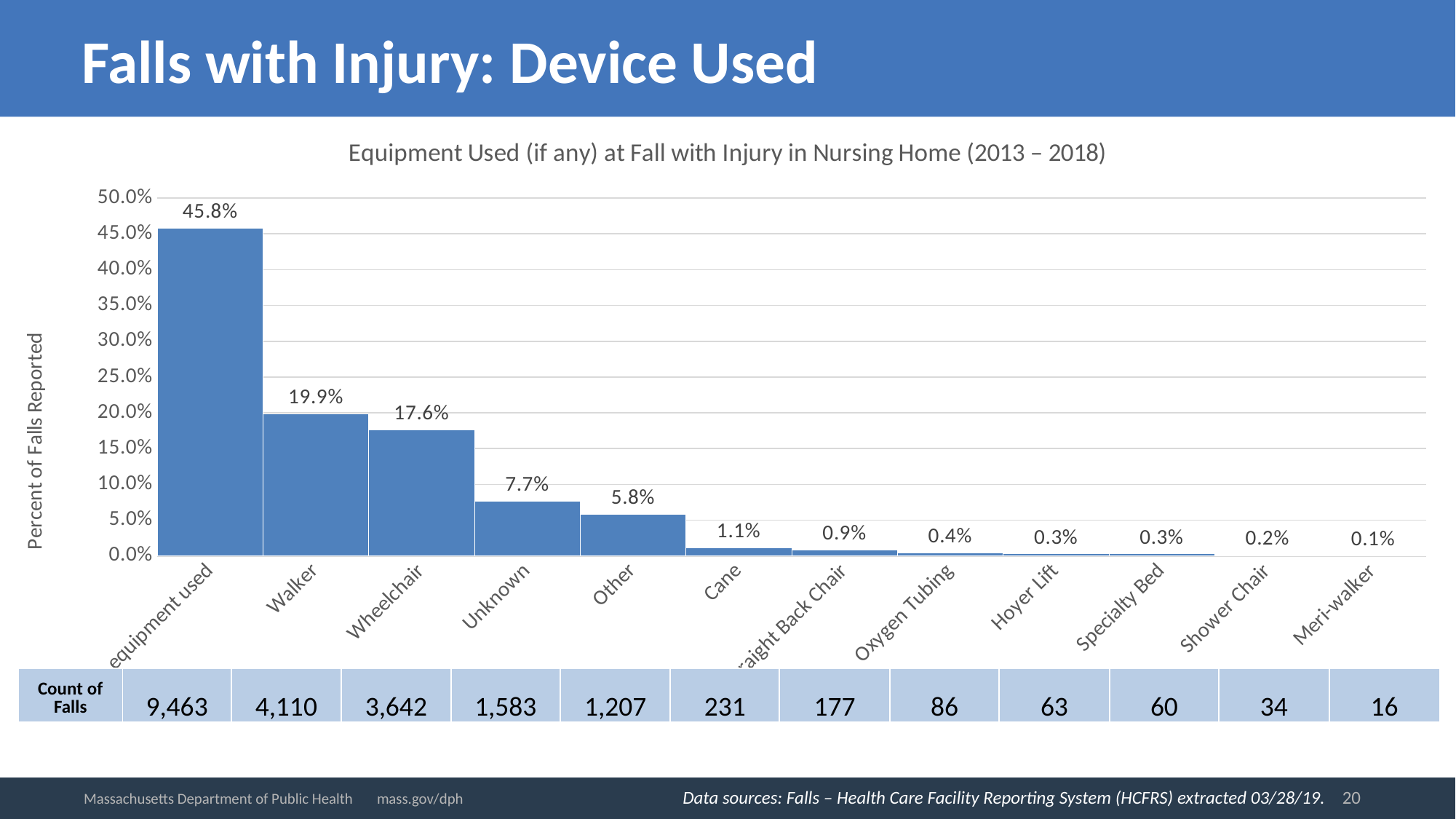
What is the title of the chart? Equipment Used (if any) at Fall with Injury in Nursing Home (2013 – 2018) Which device category has the lowest percent of falls reported? Meri-walker What percent of falls reported involved a Walker? 19.9% What is the difference in percent of falls reported between Walker and Wheelchair? 2.3% What is the count of falls for the Cane category? 231 What is the highest percent value shown on the chart? 45.8% Is the value for Walker greater or less than 20.0%? less What percent of falls reported involved a Wheelchair? 17.6% How many device categories are shown on the chart? 12 What type of chart is shown on the slide? Bar chart What is the count of falls for Oxygen Tubing? 86 Which has a higher percent of falls reported, Unknown or Other? Unknown